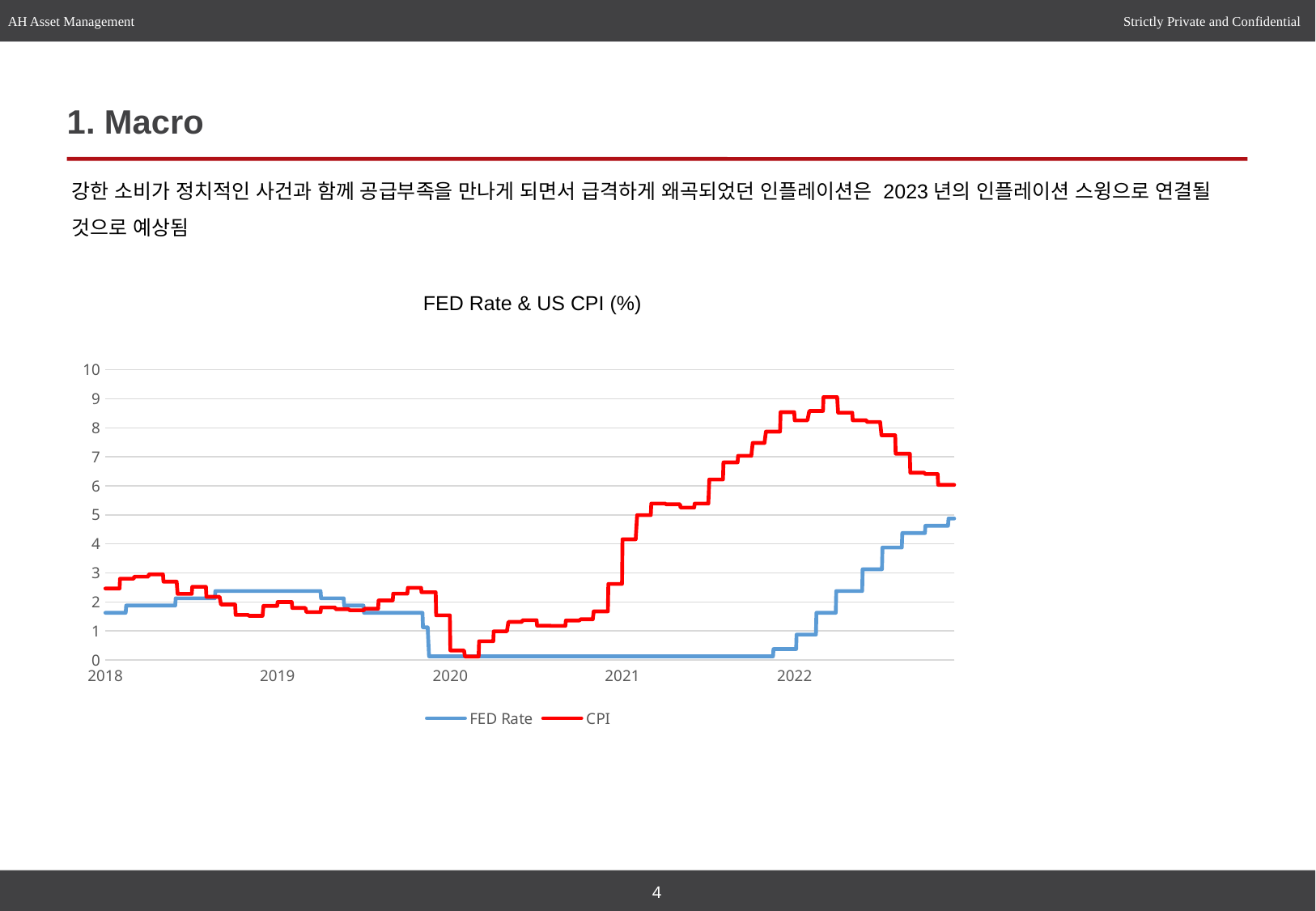
Is the FED Rate at the end of 2022 greater or less than 4? greater How many year labels are shown on the x axis? 5 Is the peak value of CPI greater or less than 8? greater In early 2019, which is higher, the FED Rate or CPI? FED Rate Which series is drawn in red? CPI How many series does the legend list? 2 At the end of 2022, which is higher, the FED Rate or CPI? CPI Which series reaches the highest value on the chart? CPI What is the title of the chart? FED Rate & US CPI (%) What kind of chart is shown on the slide? line chart Is the FED Rate during 2021 greater or less than 1? less Does the FED Rate rise or fall over the course of 2022? rise